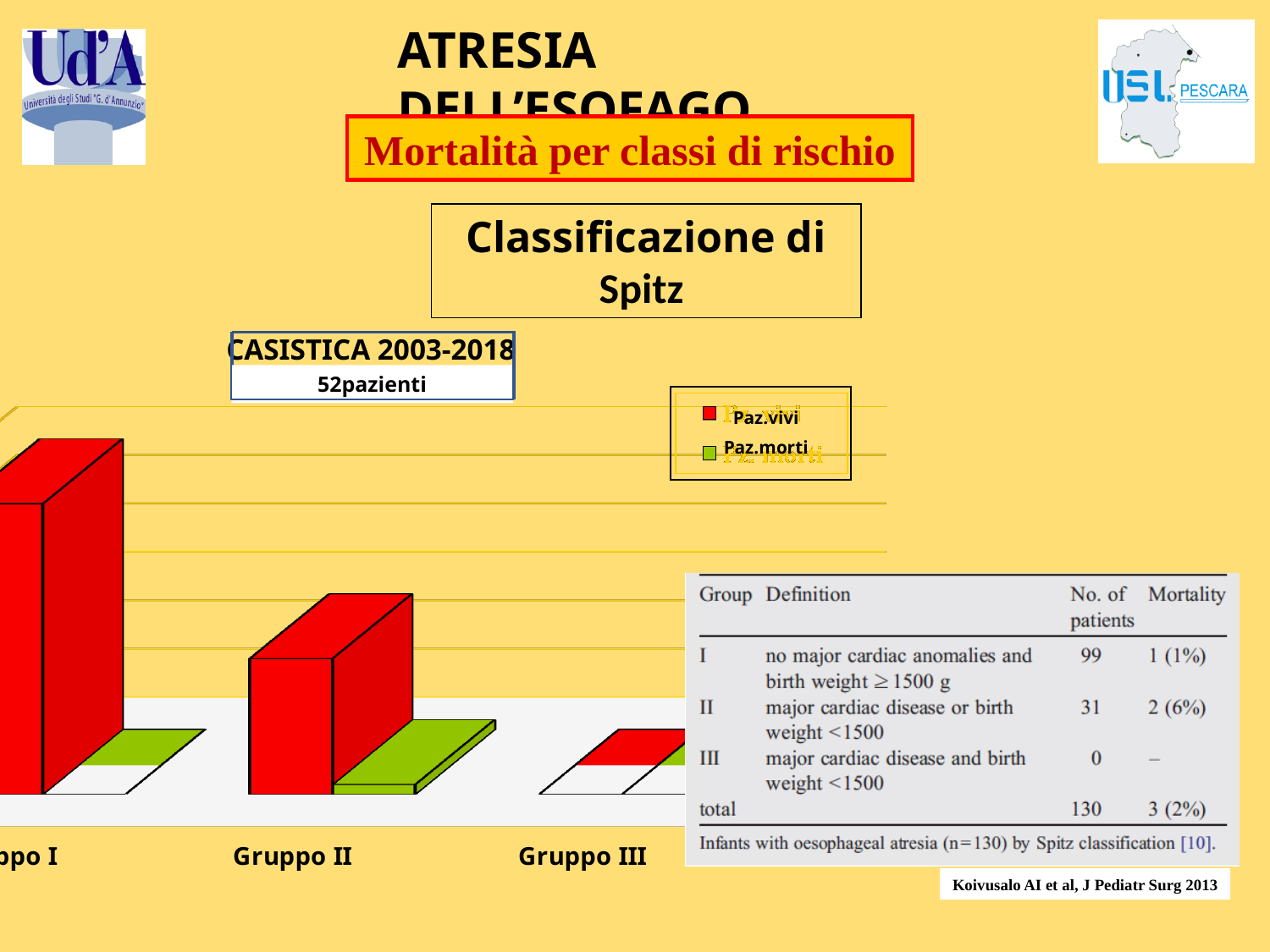
How many series does the chart legend list? 2 Which group has the highest value for Paz.vivi? Gruppo I Do the Paz.vivi values rise or fall from Gruppo I to Gruppo III? fall In Gruppo II, which series has the larger value, Paz.vivi or Paz.morti? Paz.vivi Is the Paz.vivi value larger for Gruppo I or for Gruppo II? Gruppo I Which colour represents Paz.vivi in the chart? red Which colour represents Paz.morti in the chart? green How many groups (categories) are shown along the x axis of the chart? 3 What kind of chart is shown on the slide? bar chart Which group has the lowest value for Paz.vivi? Gruppo III